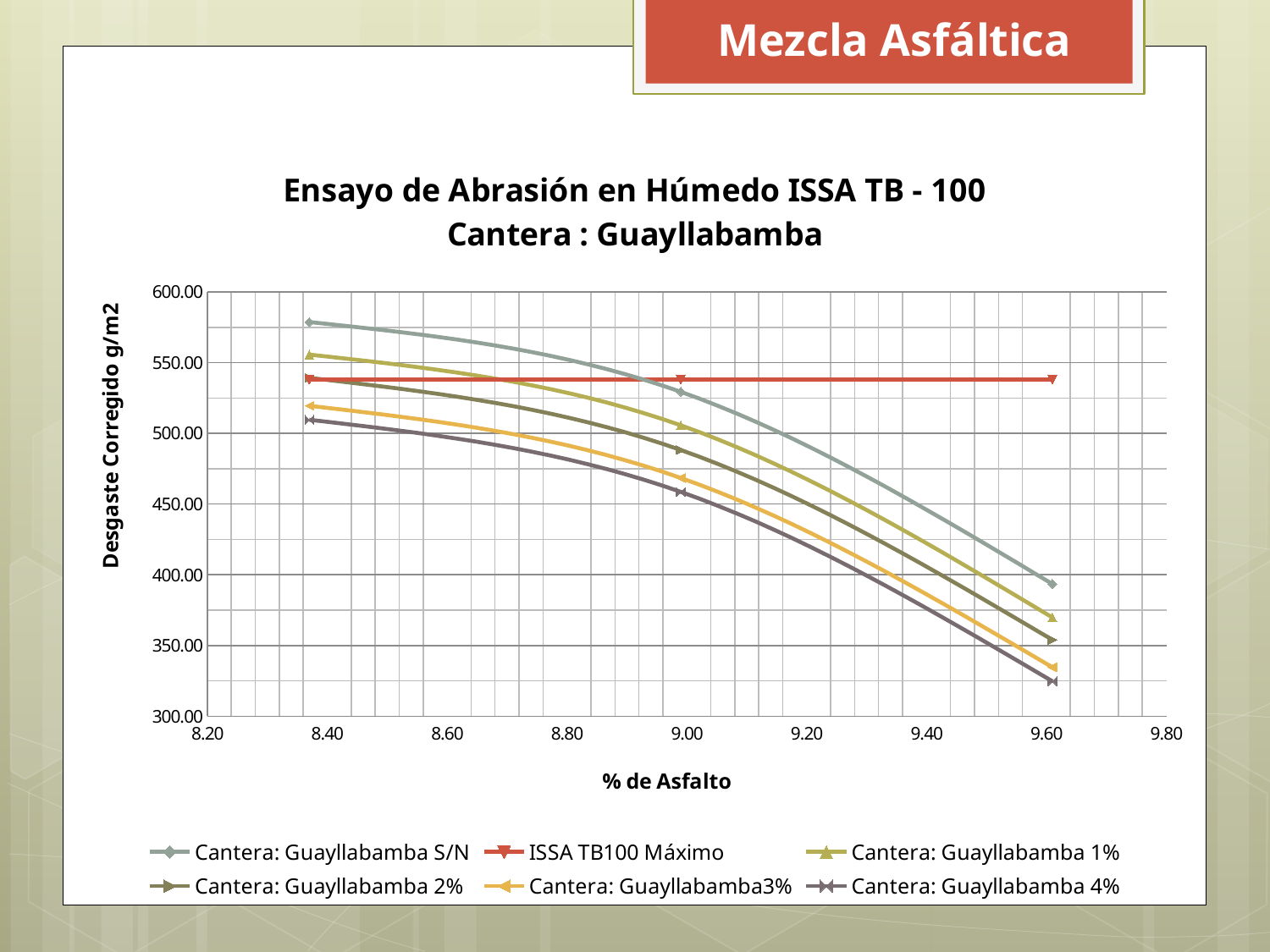
Is the value for Cantera: Guayllabamba 1% at about 9.60 % de Asfalto greater or less than 400.00? less At about 9.60 % de Asfalto, which is larger: Cantera: Guayllabamba S/N or Cantera: Guayllabamba 4%? Cantera: Guayllabamba S/N Which series has the lowest value at about 9.60 % de Asfalto? Cantera: Guayllabamba 4% Is the value for Cantera: Guayllabamba S/N at about 8.40 % de Asfalto greater or less than 550.00? greater Does the value for Cantera: Guayllabamba S/N rise or fall as % de Asfalto increases? Fall How many data points are plotted for the series Cantera: Guayllabamba S/N? 3 Is the ISSA TB100 Máximo line greater or less than 550.00? less What is the title of the vertical axis? Desgaste Corregido g/m2 How many series does the legend list? 6 Does the ISSA TB100 Máximo series rise, fall or stay flat across the x axis? Stay flat What kind of chart is shown on the slide? Line chart